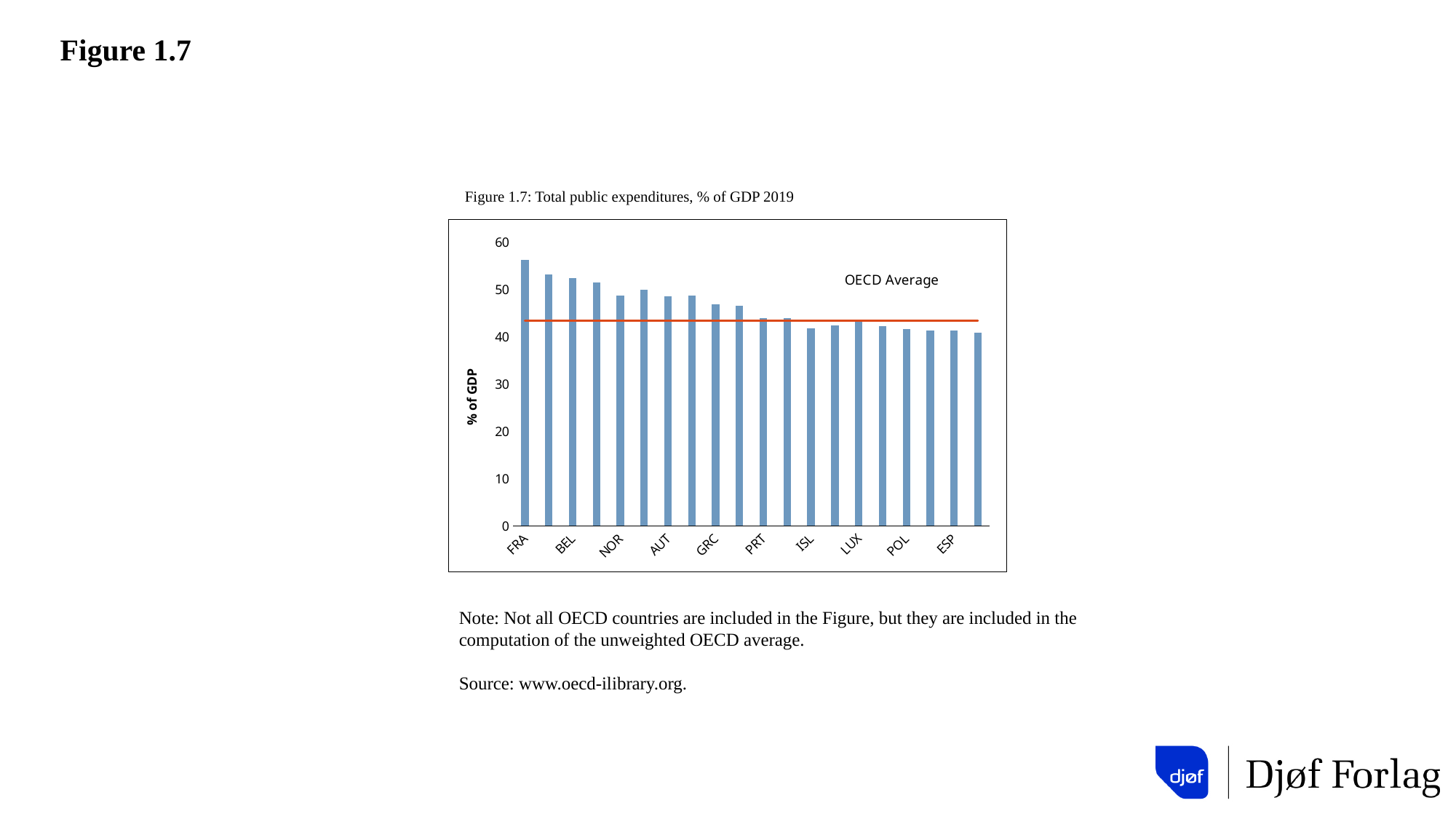
Do the bar values rise or fall from left to right along the x axis? fall How many bars are plotted in the chart? 20 Is the value for FRA greater or less than 50? greater What is the label of the vertical axis? % of GDP What is the title of the chart? Figure 1.7: Total public expenditures, % of GDP 2019 Is the value for BEL greater or less than 50? greater What kind of chart is shown on the slide? bar chart Which is larger, the value for FRA or the value for ESP? FRA Which is larger, the value for BEL or the value for PRT? BEL Is the value for ESP greater or less than 50? less Which country has the highest total public expenditure as % of GDP? FRA